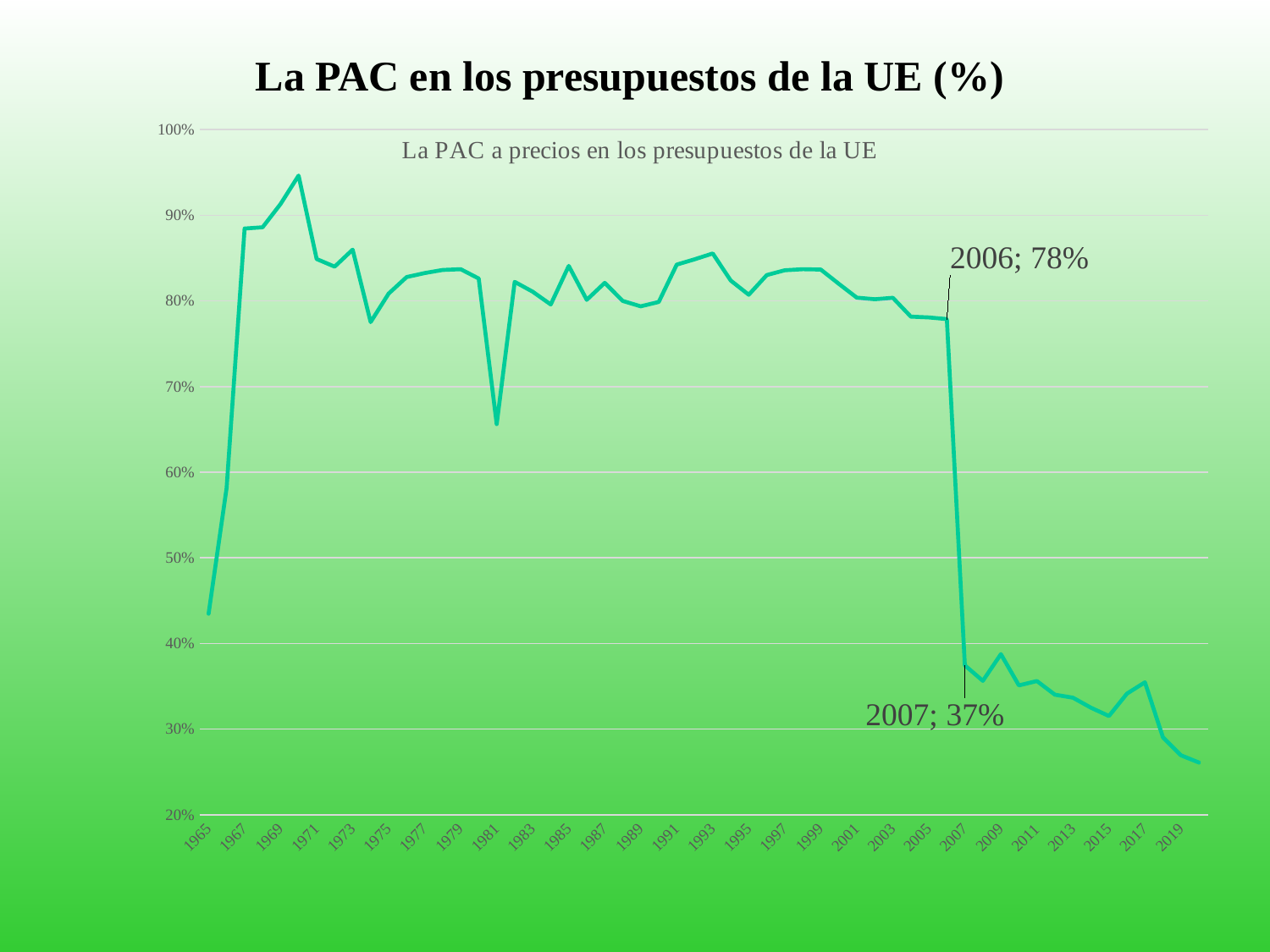
What value is labelled for 2007? 37% Is the value for 1981 greater or less than 70%? less What is the title shown inside the chart area? La PAC a precios en los presupuestos de la UE What is the difference between the labelled values for 2006 and 2007? 41% Is the value for 1999 greater or less than 80%? greater Which year has the larger labelled value, 2006 or 2007? 2006 Is the value for 1965 greater or less than 50%? less What value is labelled for 2006? 78% Do the values generally rise or fall from 2007 to 2019? fall What is the lowest value shown on the vertical axis? 20% What kind of chart is shown on the slide? Line chart